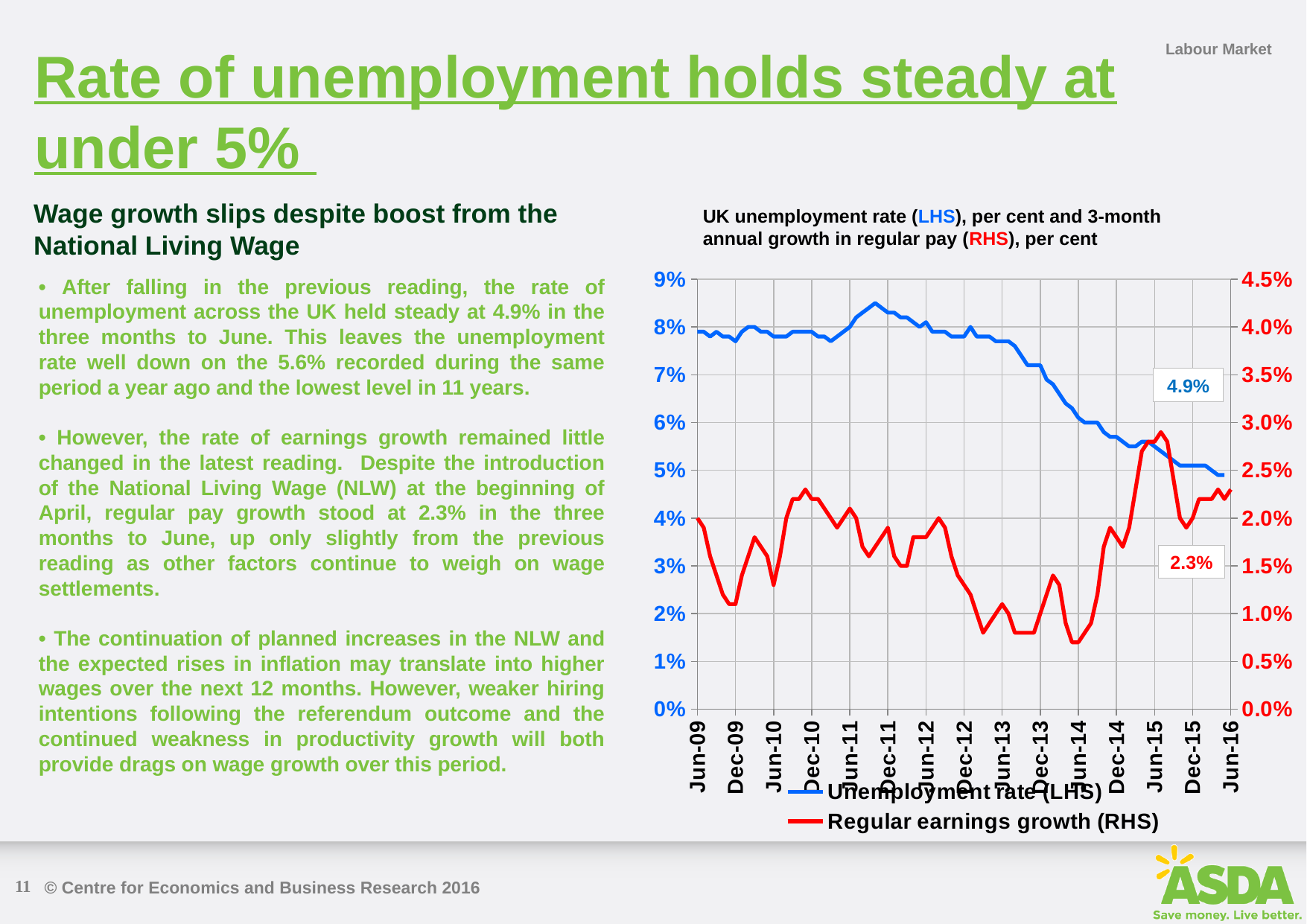
What is the latest labelled value of the unemployment rate (LHS) on the chart? 4.9% How many series does the chart legend list? 2 Overall, does the unemployment rate line rise or fall between Jun-09 and Jun-16? fall What colour is the line for the unemployment rate (LHS)? blue Is the unemployment rate at Dec-11 greater or less than 8% on the left-hand axis? greater How many date labels are shown on the x axis of the chart? 15 What type of chart is shown on the slide? line chart What is the highest tick value shown on the right-hand axis of the chart? 4.5% Is regular earnings growth at Dec-09 greater or less than 1.5% on the right-hand axis? less Is the unemployment rate at Jun-14 greater or less than 7% on the left-hand axis? less What is the latest labelled value of regular earnings growth (RHS) on the chart? 2.3%